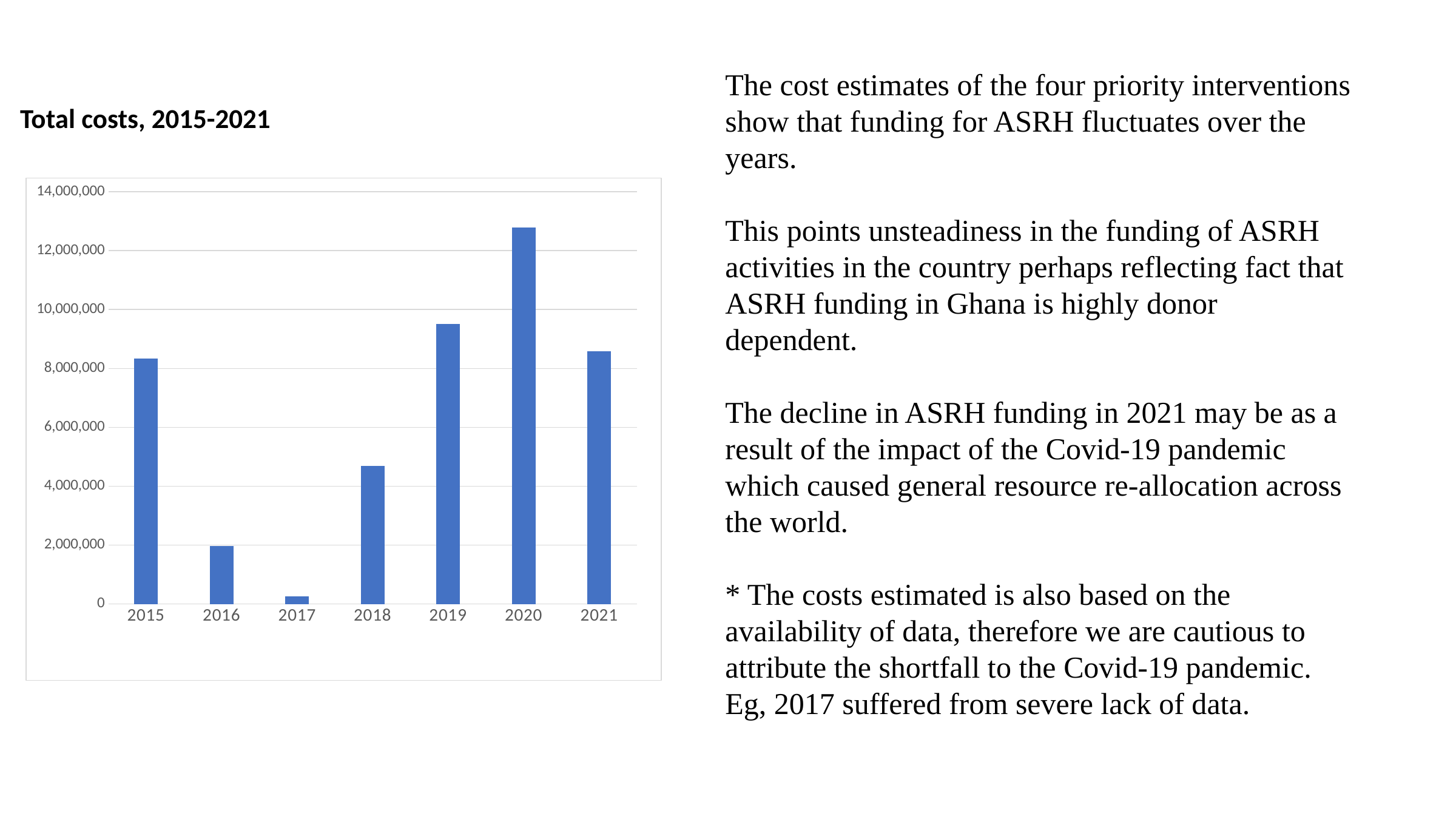
Which year has the highest total cost? 2020 Is the value for 2016 greater or less than 4,000,000? less Do the total costs rise or fall from 2017 to 2020? rise Is the value for 2018 greater or less than 4,000,000? greater What is the title of the chart? Total costs, 2015-2021 Which year has the larger total cost, 2019 or 2021? 2019 What kind of chart is shown on the slide? Bar chart Is the value for 2019 greater or less than 10,000,000? less How many years are shown on the x axis of the chart? 7 Which year has the lowest total cost? 2017